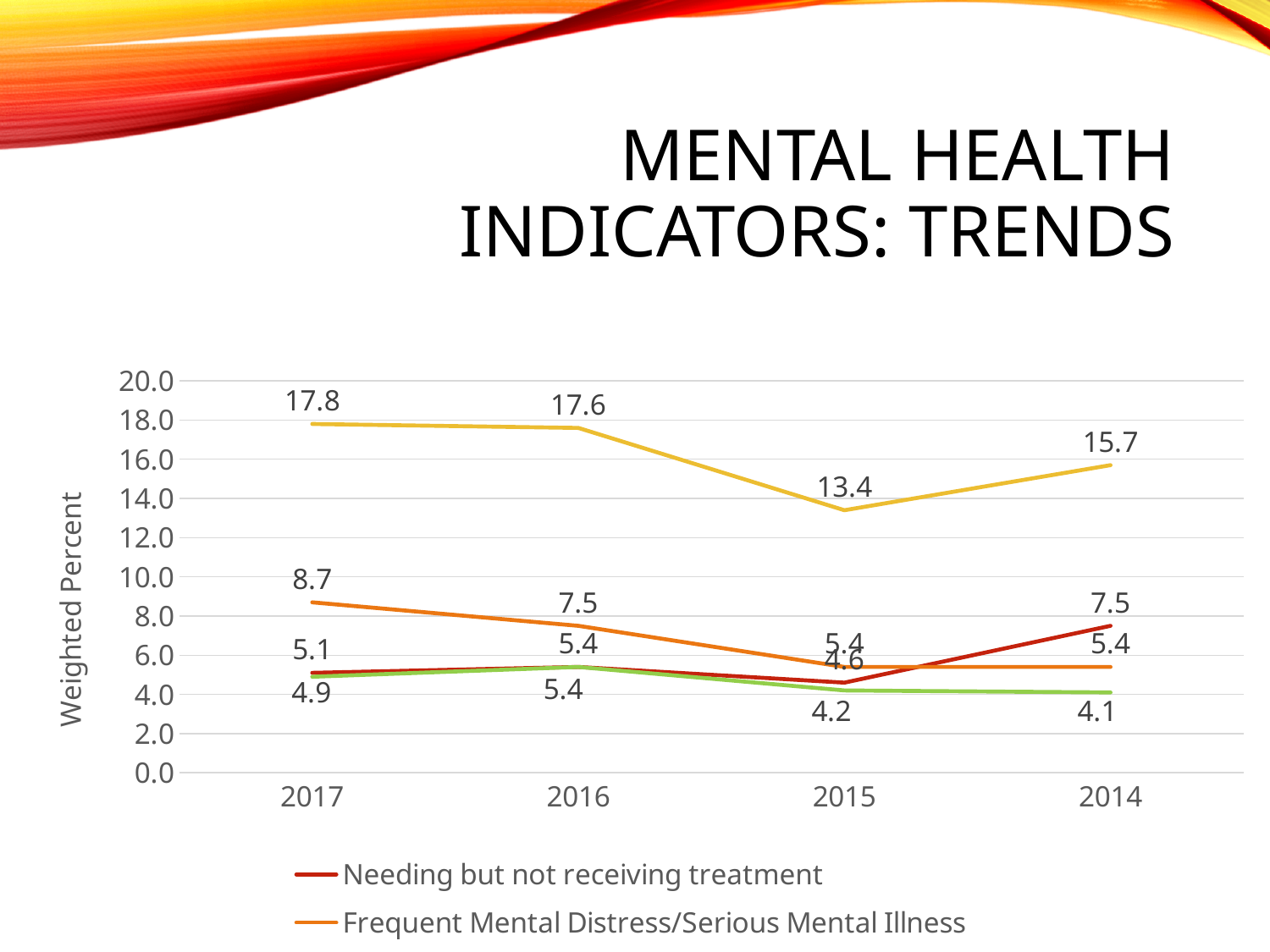
What is the value for Needing but not receiving treatment in 2015? 4.6 What is the difference between the Needing but not receiving treatment values for 2014 and 2015? 2.9 What is the value for Needing but not receiving treatment in 2014? 7.5 What is the difference between the Frequent Mental Distress/Serious Mental Illness values for 2017 and 2016? 1.2 In 2014, which is larger: Needing but not receiving treatment or Frequent Mental Distress/Serious Mental Illness? Needing but not receiving treatment What kind of chart is shown on the slide? Line chart How many years are shown on the x axis? 4 In which year is Needing but not receiving treatment lowest? 2015 What is the title of the vertical axis? Weighted Percent What is the value of the yellow line in 2015? 13.4 What is the value for Frequent Mental Distress/Serious Mental Illness in 2017? 8.7 In which year is Frequent Mental Distress/Serious Mental Illness highest? 2017